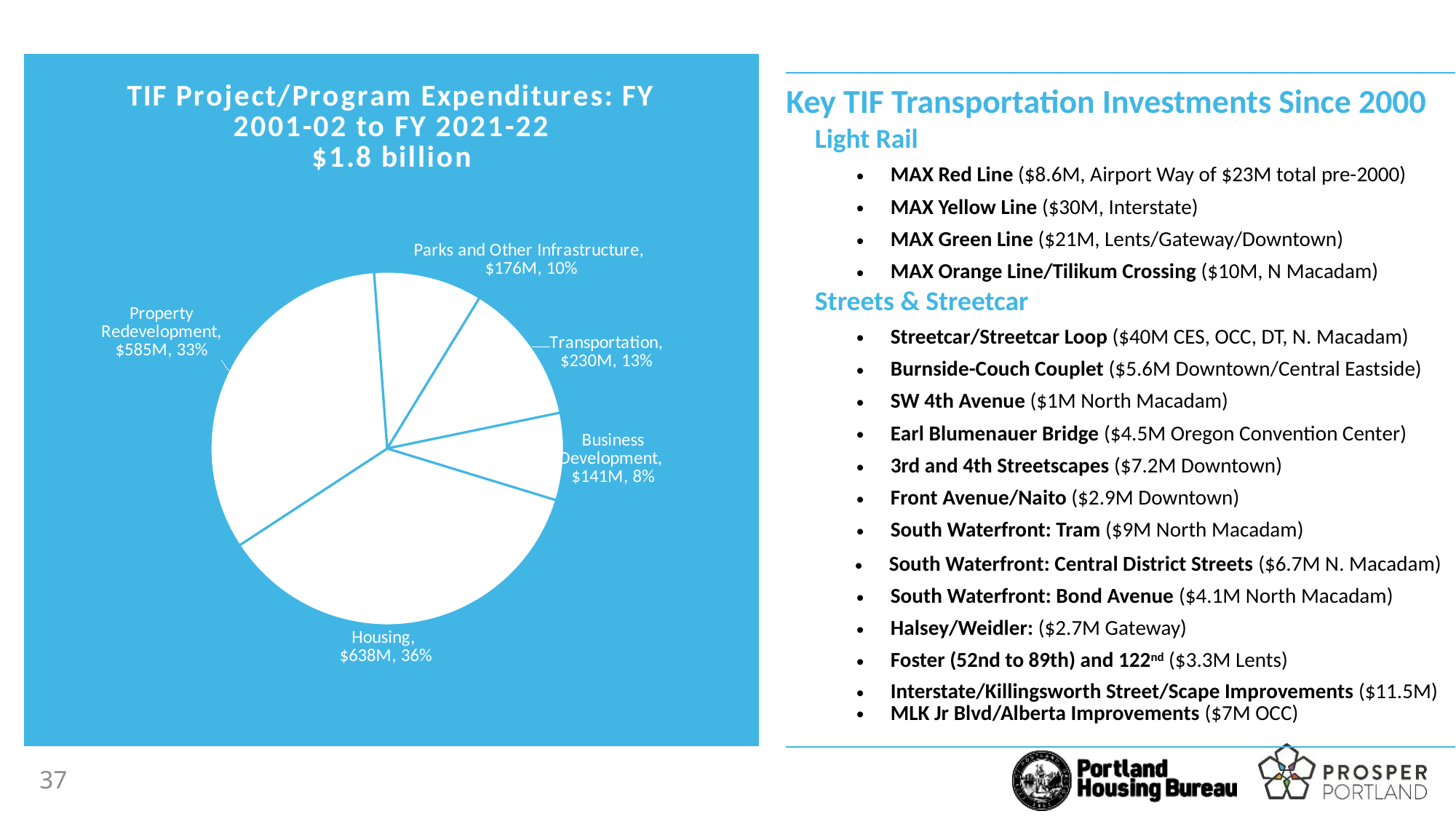
What percentage share does Property Redevelopment have? 33% What percentage share does Transportation have in the pie chart? 13% What is the expenditure amount for Parks and Other Infrastructure? $176M What type of chart is shown on the slide? pie chart What is the expenditure amount for Housing? $638M What is the expenditure amount for Business Development? $141M What total amount is stated in the chart title? $1.8 billion How many categories are shown in the pie chart? 5 Which is larger, the expenditure for Transportation or for Parks and Other Infrastructure? Transportation What is the difference in expenditures between Housing and Property Redevelopment? $53M Which category has the smallest share of expenditures? Business Development Which category has the largest share of expenditures? Housing